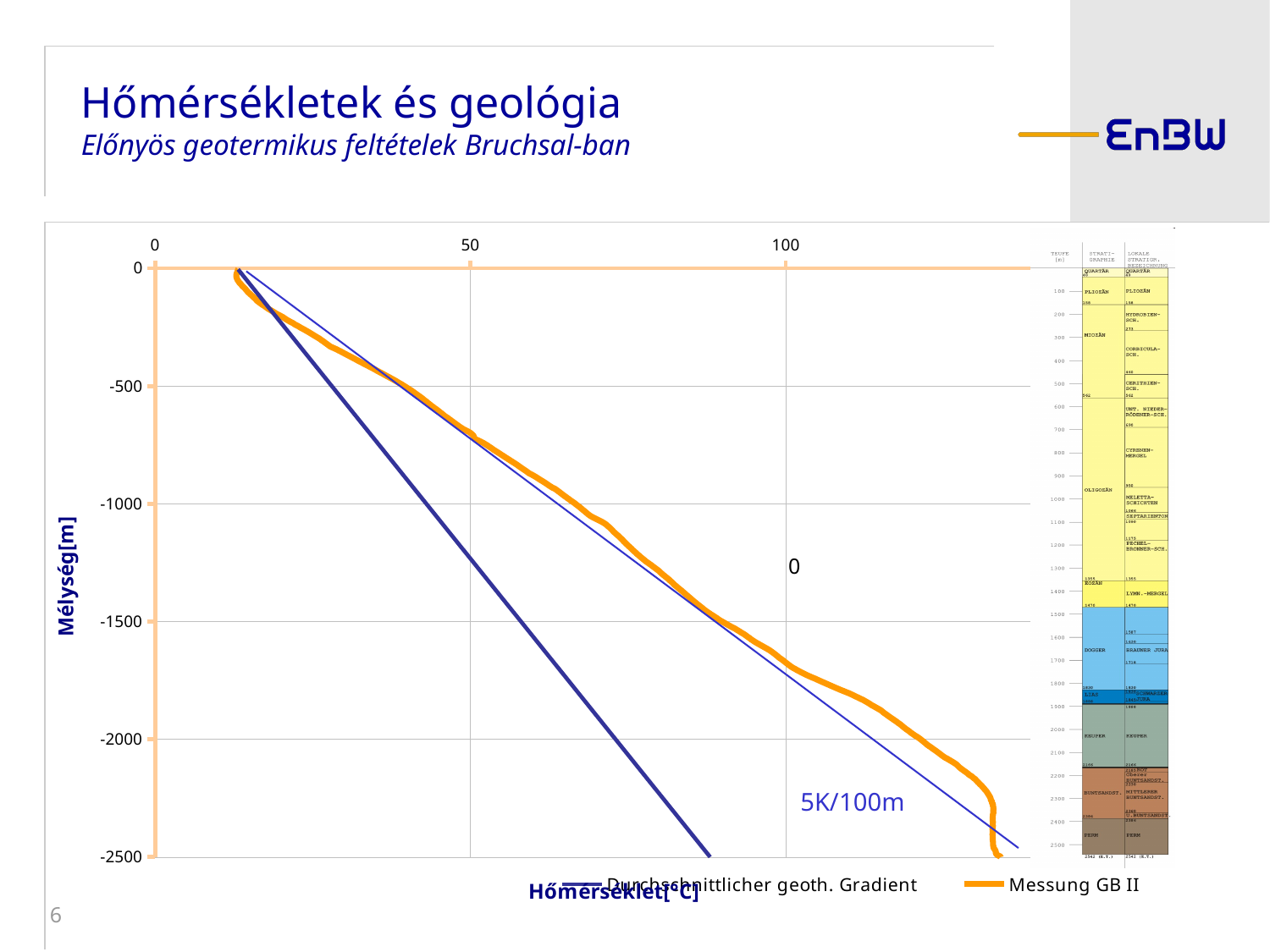
How many series does the chart legend list? 2 Is the temperature of the Durchschnittlicher geoth. Gradient series at a depth of -2500 m greater or less than 100? less Does the temperature of the Messung GB II series rise or fall as depth increases from 0 m to -2500 m? rise What is the label of the vertical axis of the chart? Mélység[m] Is the temperature of the Messung GB II series at a depth of -1000 m greater or less than 50? greater At a depth of -2000 m, which series shows the higher temperature, Messung GB II or Durchschnittlicher geoth. Gradient? Messung GB II What kind of chart is shown on the slide? line chart Is the temperature of the Messung GB II series at a depth of -2500 m greater or less than 100? greater What are the two series named in the chart legend? Durchschnittlicher geoth. Gradient and Messung GB II What is the lowest depth value shown on the vertical axis of the chart? -2500 Which series is drawn in orange on the chart? Messung GB II